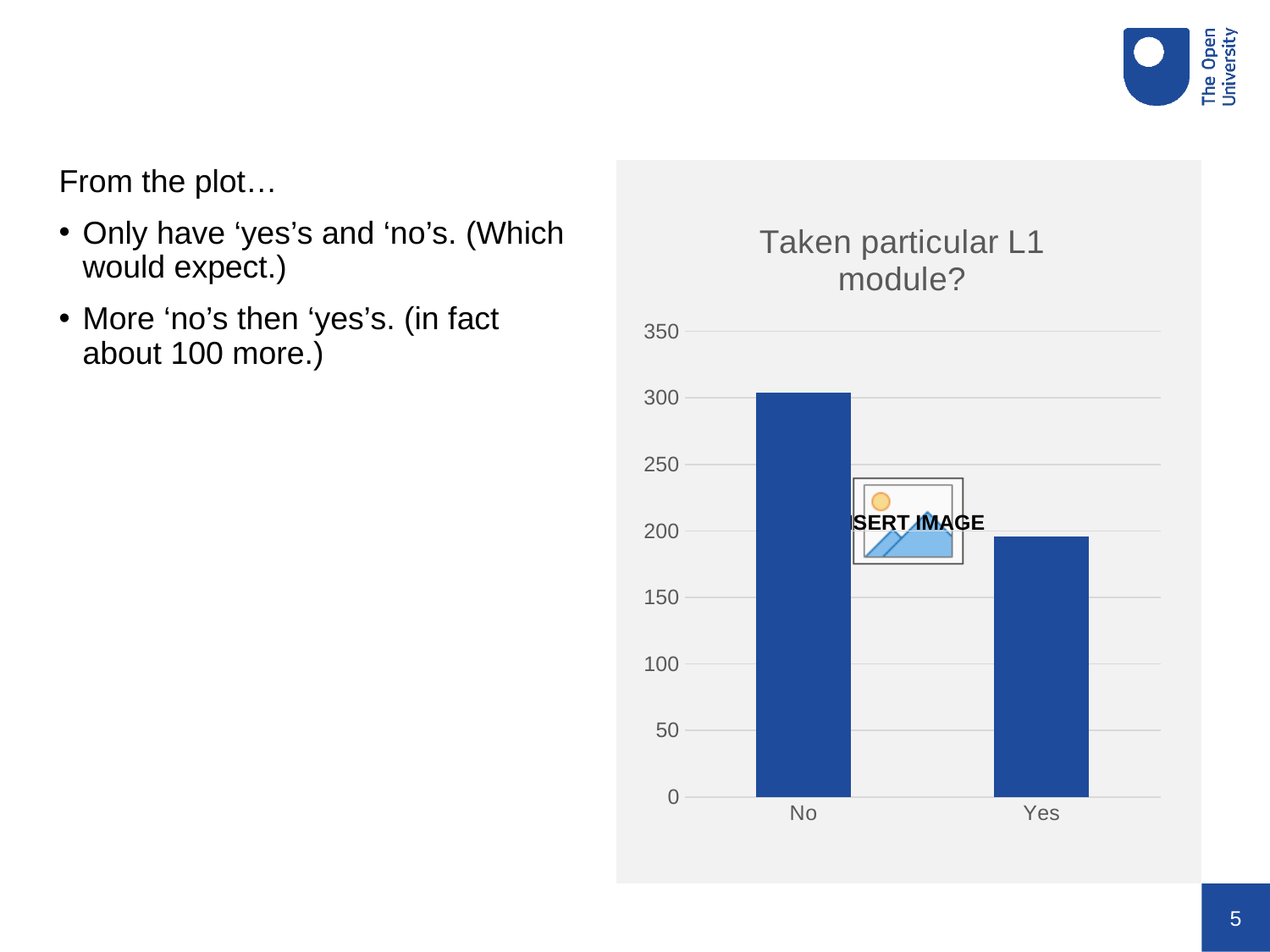
What is the title of the chart? Taken particular L1 module? Is the value for Yes greater or less than 150? greater What is the highest value shown on the y axis of the chart? 350 Which category has the highest value in the chart? No Is the value for No greater or less than 350? less How many categories are shown on the x axis of the chart? 2 Is the value for Yes greater or less than 250? less Which is larger, the value for No or the value for Yes? No What kind of chart is shown on the slide? bar chart Which category has the lowest value in the chart? Yes